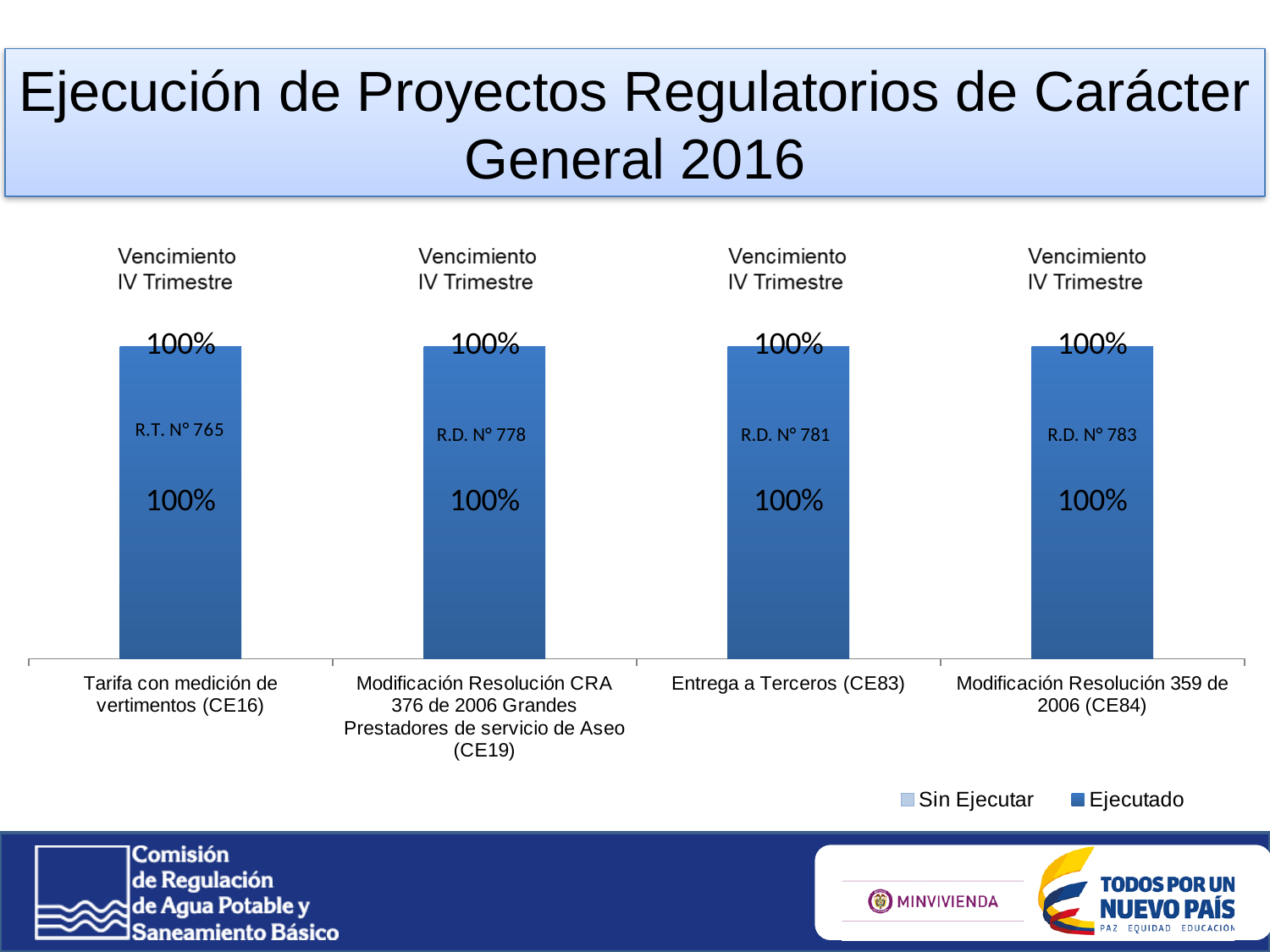
What is the Ejecutado value for Modificación Resolución 359 de 2006 (CE84)? 100% How many categories are plotted on the chart? 4 What kind of chart is shown on the slide? bar chart What resolution label is printed inside the bar for Entrega a Terceros (CE83)? R.D. N° 781 How many series does the legend list? 2 What is the title of the slide containing the chart? Ejecución de Proyectos Regulatorios de Carácter General 2016 What is the Ejecutado value for Entrega a Terceros (CE83)? 100% What resolution label is printed inside the bar for Tarifa con medición de vertimentos (CE16)? R.T. N° 765 What is the Ejecutado value for Tarifa con medición de vertimentos (CE16)? 100% What is the Ejecutado value for Modificación Resolución CRA 376 de 2006 Grandes Prestadores de servicio de Aseo (CE19)? 100% What are the two series named in the legend? Sin Ejecutar and Ejecutado What is the difference between the Ejecutado values for CE16 and CE84? 0%